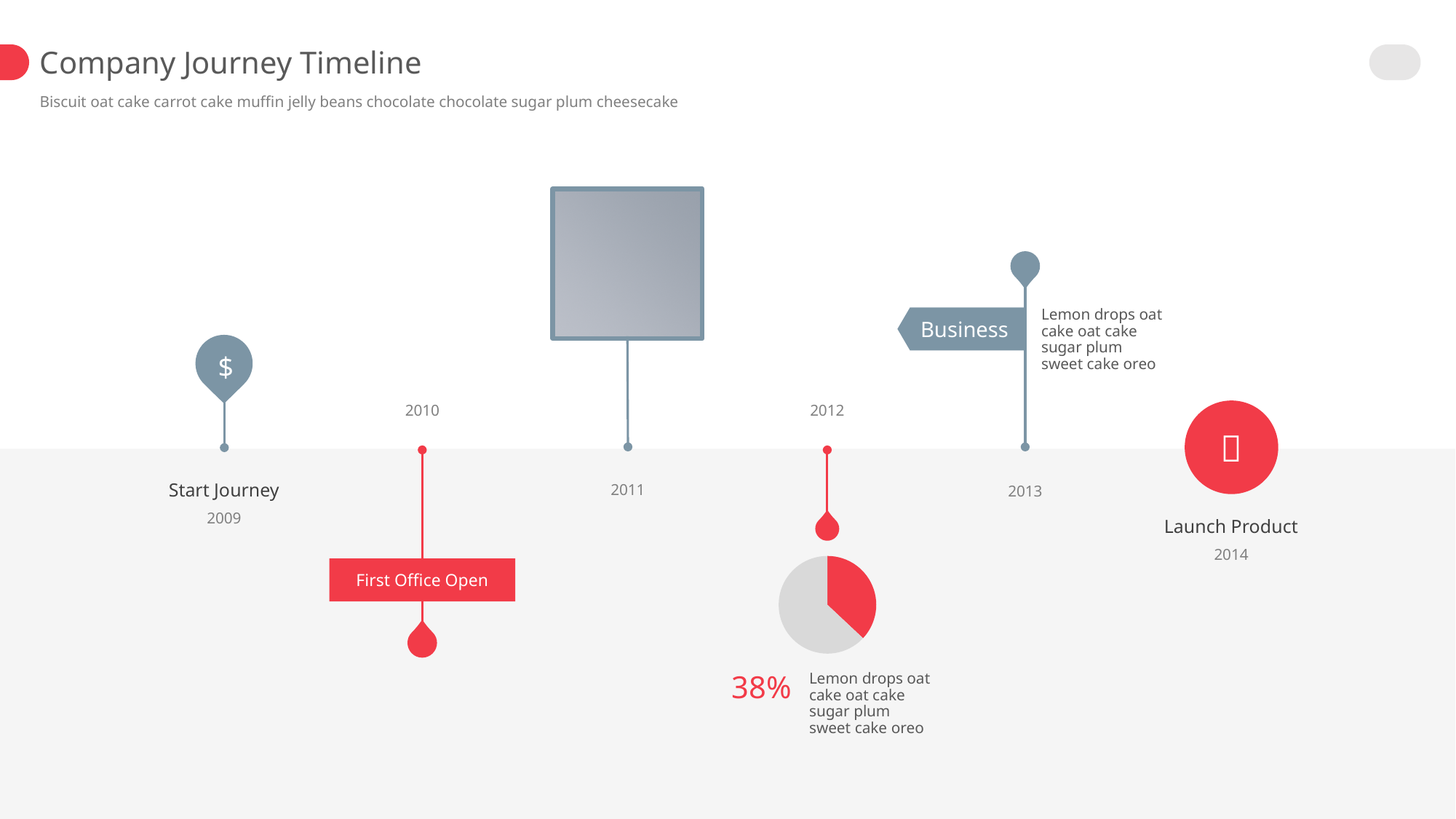
Does the pie chart below the 2012 marker have a legend? No What kind of chart is shown below the 2012 marker on the timeline? pie chart In the pie chart below the 2012 marker, which slice is the smallest? the red slice What colour is the slice labelled 38% in the pie chart below the 2012 marker? red In the pie chart below the 2012 marker, which slice is larger, the red one or the grey one? the grey one In the pie chart below the 2012 marker, what share does the red slice represent? 38% How many slices does the pie chart below the 2012 marker have? 2